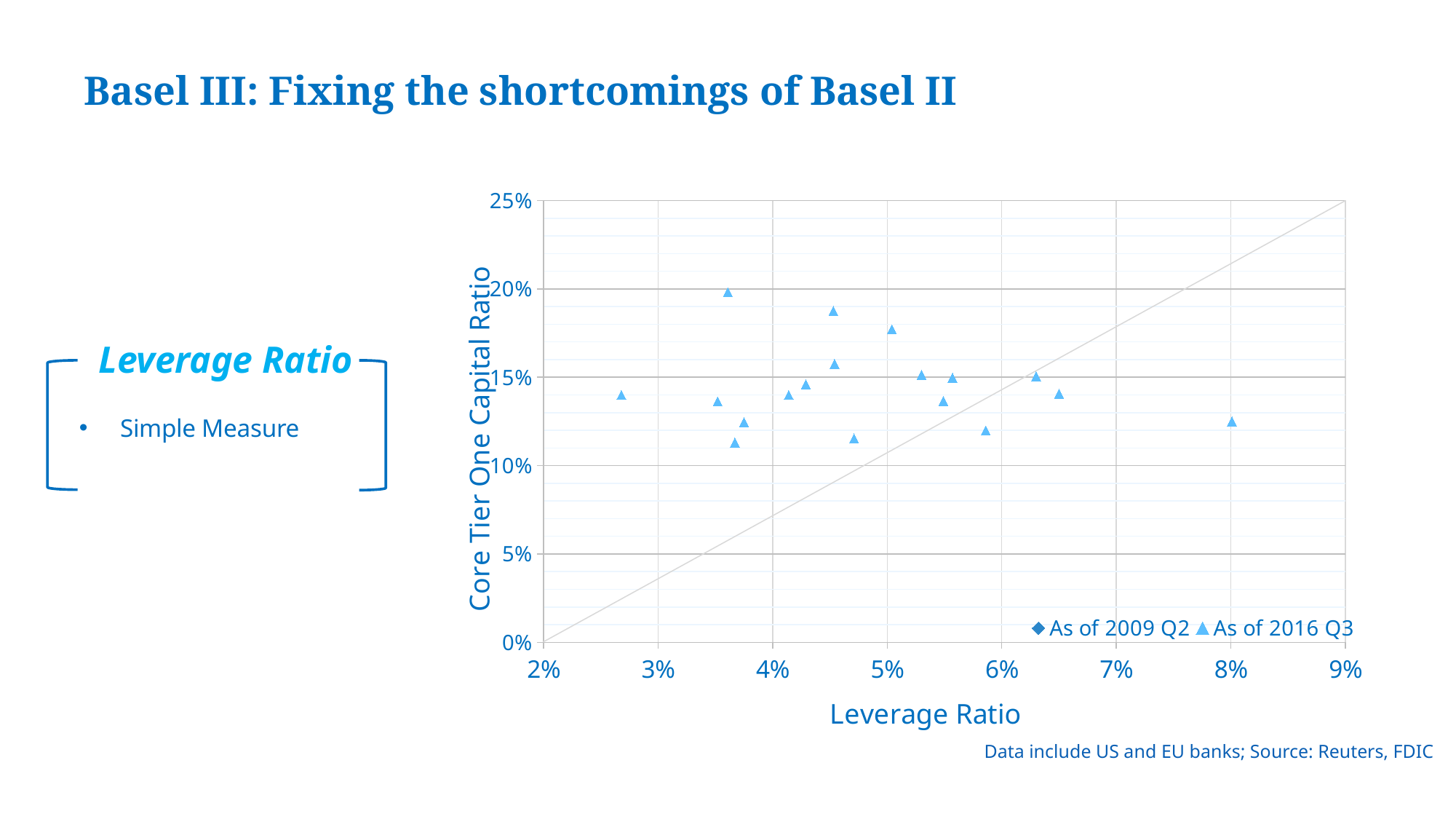
What kind of chart is shown on the slide? scatter chart Is the lowest Core Tier One Capital Ratio plotted on the chart greater or less than 10%? greater Is the Core Tier One Capital Ratio of the point with the highest Leverage Ratio greater or less than 15%? less Is the highest Leverage Ratio plotted on the chart greater or less than 7%? greater What is the title of the chart's y axis? Core Tier One Capital Ratio What is the maximum value shown on the chart's x axis? 9% Which series in the legend is plotted with triangle markers? As of 2016 Q3 How many series does the chart's legend list? 2